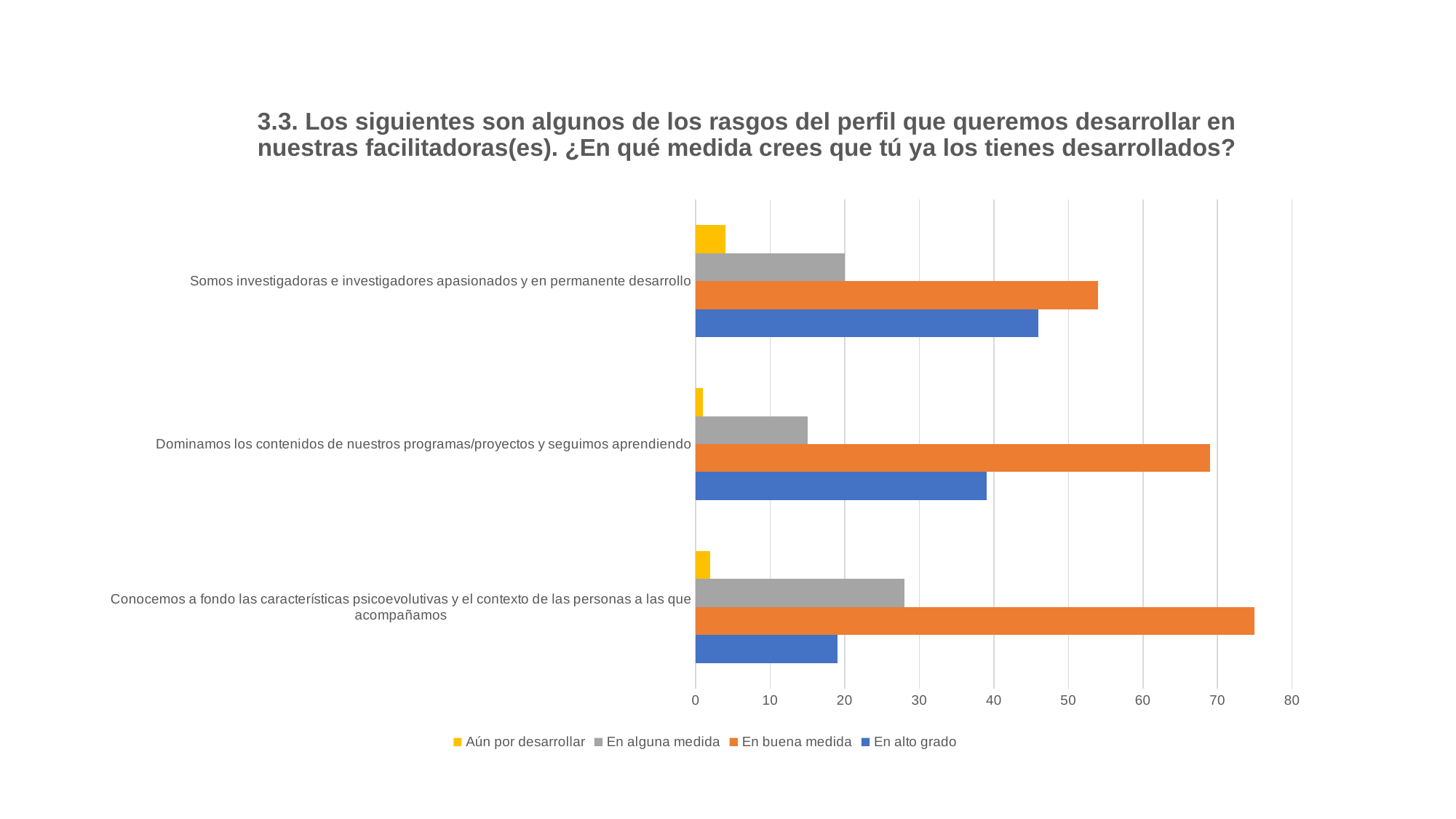
Which category has the highest value for the series "Aún por desarrollar"? Somos investigadoras e investigadores apasionados y en permanente desarrollo How many categories (profile traits) are shown on the chart? 3 For "Somos investigadoras e investigadores apasionados y en permanente desarrollo", which is larger: "En buena medida" or "En alto grado"? En buena medida Which category has the lowest value for the series "En alto grado"? Conocemos a fondo las características psicoevolutivas y el contexto de las personas a las que acompañamos Which series is shown in orange in the legend? En buena medida Is the value of "En alguna medida" for "Conocemos a fondo las características psicoevolutivas y el contexto de las personas a las que acompañamos" greater or less than 30? less Is the value of "En buena medida" for "Conocemos a fondo las características psicoevolutivas y el contexto de las personas a las que acompañamos" greater or less than 70? greater What is the highest value shown on the horizontal axis? 80 How many series does the legend list? 4 Which category has the highest value for the series "En buena medida"? Conocemos a fondo las características psicoevolutivas y el contexto de las personas a las que acompañamos What kind of chart is shown on the slide? bar chart